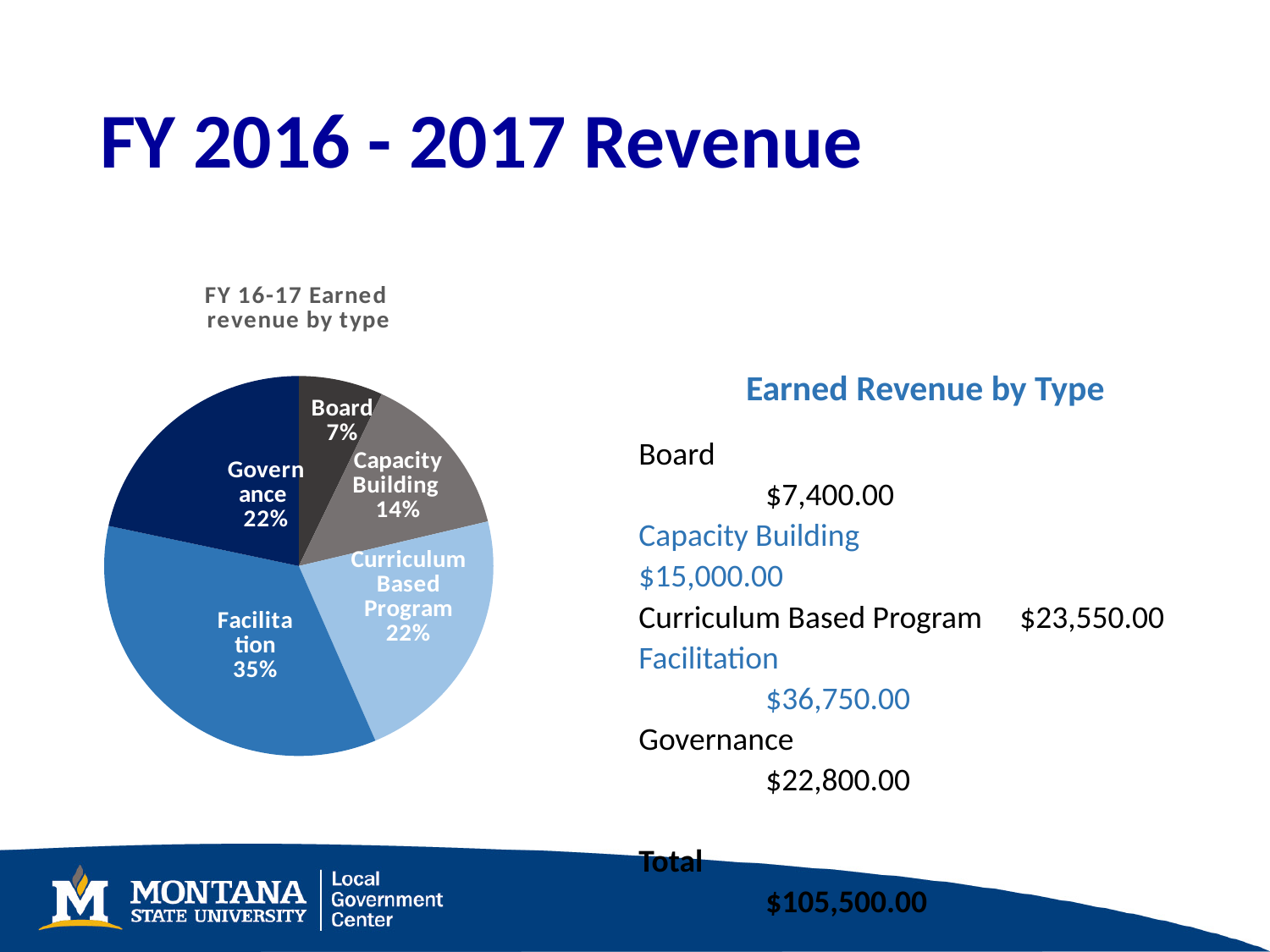
What share of earned revenue does Facilitation represent in the pie chart? 35% How many slices does the pie chart have? 5 What percentage is shown for Capacity Building in the pie chart? 14% Which category has the largest slice in the pie chart? Facilitation What percentage is shown for Governance in the pie chart? 22% Which slice is larger in the pie chart, Capacity Building or Board? Capacity Building By how many percentage points does the Facilitation slice exceed the Board slice? 28 percentage points What type of chart is shown on the slide? Pie chart Which category has the smallest slice in the pie chart? Board What percentage is shown for Curriculum Based Program in the pie chart? 22% What percentage is shown for Board in the pie chart? 7% What is the title of the pie chart? FY 16-17 Earned revenue by type